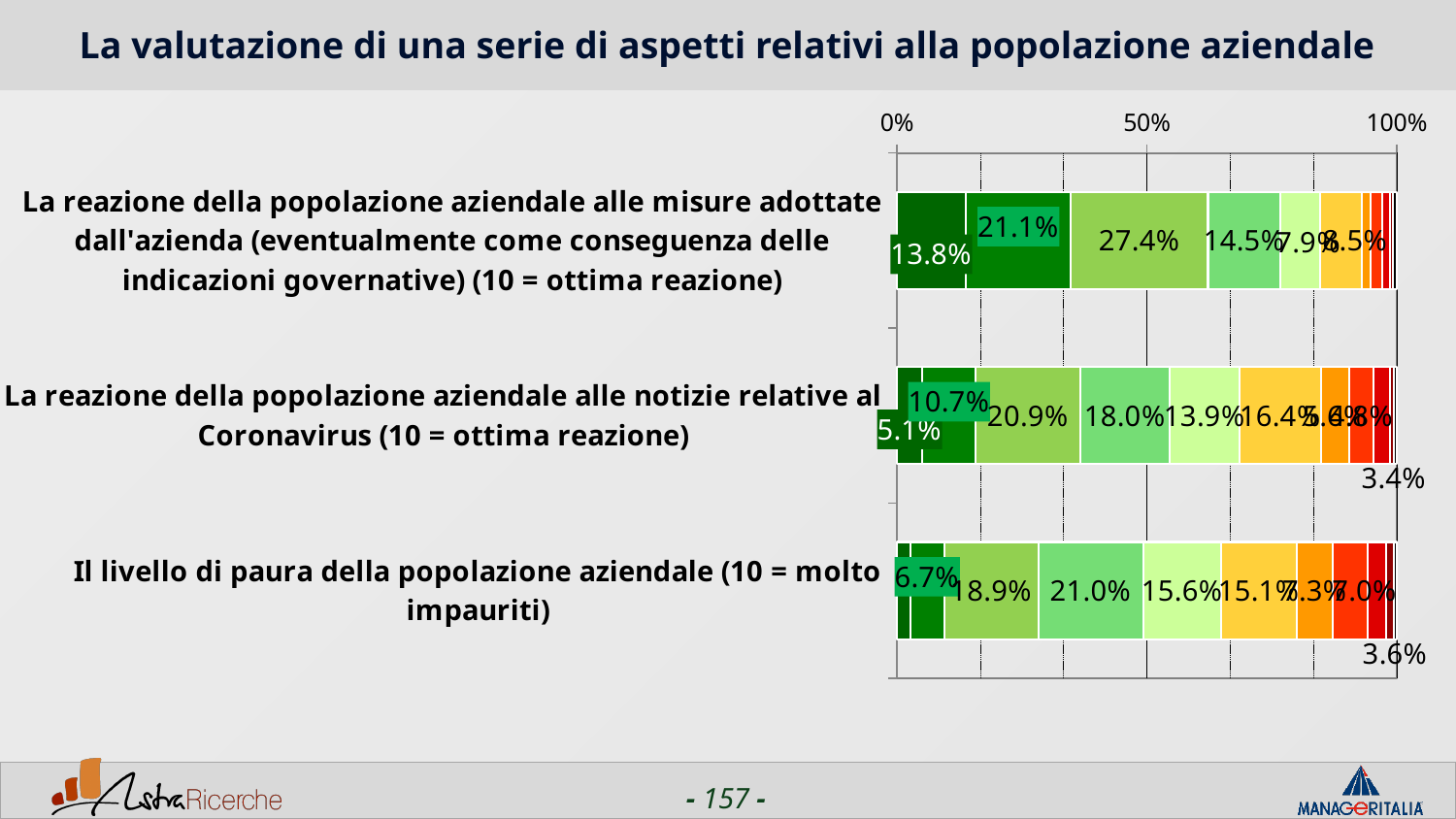
How many categories (bars) does the chart show? 3 What are the minimum and maximum values shown on the horizontal axis? 0% and 100% In the bar for 'La reazione della popolazione aziendale alle misure adottate dall'azienda', what is the difference between the third segment (27.4%) and the second segment (21.1%)? 6.3 percentage points What is the value of the leftmost (dark green) segment of the bar for 'La reazione della popolazione aziendale alle notizie relative al Coronavirus'? 5.1% What kind of chart is shown on the slide? bar chart What is the value of the leftmost (dark green) segment of the bar for 'La reazione della popolazione aziendale alle misure adottate dall'azienda'? 13.8% Which bar has the larger leftmost (dark green) segment: 'La reazione della popolazione aziendale alle misure adottate dall'azienda' or 'La reazione della popolazione aziendale alle notizie relative al Coronavirus'? La reazione della popolazione aziendale alle misure adottate dall'azienda What is the value of the third segment of the bar for 'Il livello di paura della popolazione aziendale'? 21.0% What is the value of the second segment of the bar for 'La reazione della popolazione aziendale alle notizie relative al Coronavirus'? 10.7% Which category has the largest leftmost (dark green) segment? La reazione della popolazione aziendale alle misure adottate dall'azienda What is the value of the third segment of the bar for 'La reazione della popolazione aziendale alle misure adottate dall'azienda'? 27.4%